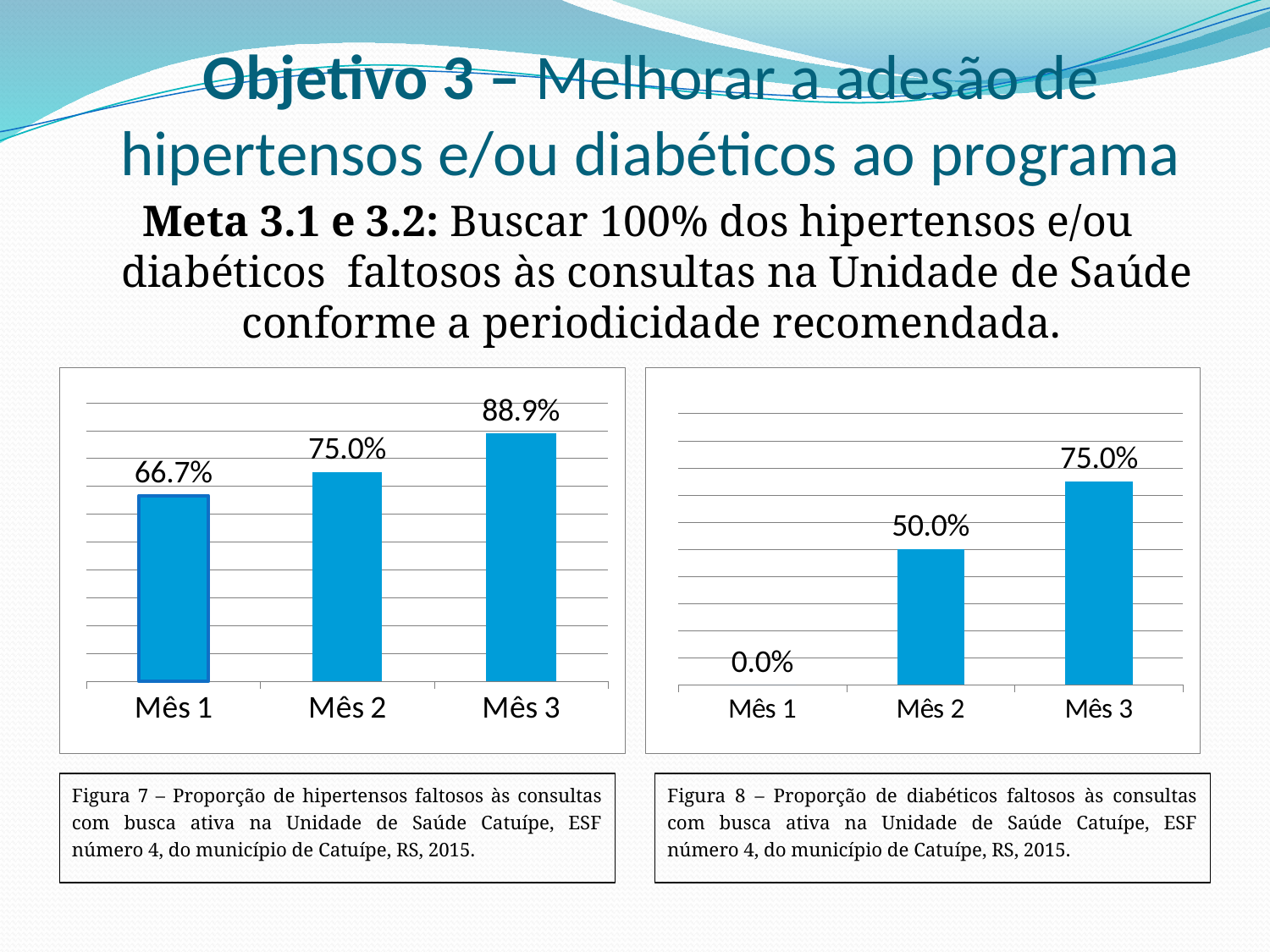
In the right chart (Figura 8, diabéticos), what is the difference between the values for Mês 3 and Mês 2? 25.0% In the left chart (Figura 7, hipertensos), what is the value for Mês 2? 75.0% In the left chart (Figura 7, hipertensos), what is the difference between the values for Mês 3 and Mês 1? 22.2% How many months (categories) are shown in the left chart (Figura 7)? 3 In the right chart (Figura 8, diabéticos), do the values rise or fall from Mês 1 to Mês 3? Rise In the left chart (Figura 7, hipertensos), what is the value for Mês 3? 88.9% In the right chart (Figura 8, diabéticos), what is the value for Mês 2? 50.0% In the right chart (Figura 8, diabéticos), which month has the highest value? Mês 3 What kind of chart is the right chart (Figura 8)? Bar chart In the left chart (Figura 7, hipertensos), which month has the lowest value? Mês 1 Which is larger: the value for Mês 2 in the left chart (Figura 7) or the value for Mês 2 in the right chart (Figura 8)? Left chart (Figura 7), 75.0% In the right chart (Figura 8, diabéticos), what is the value for Mês 1? 0.0%